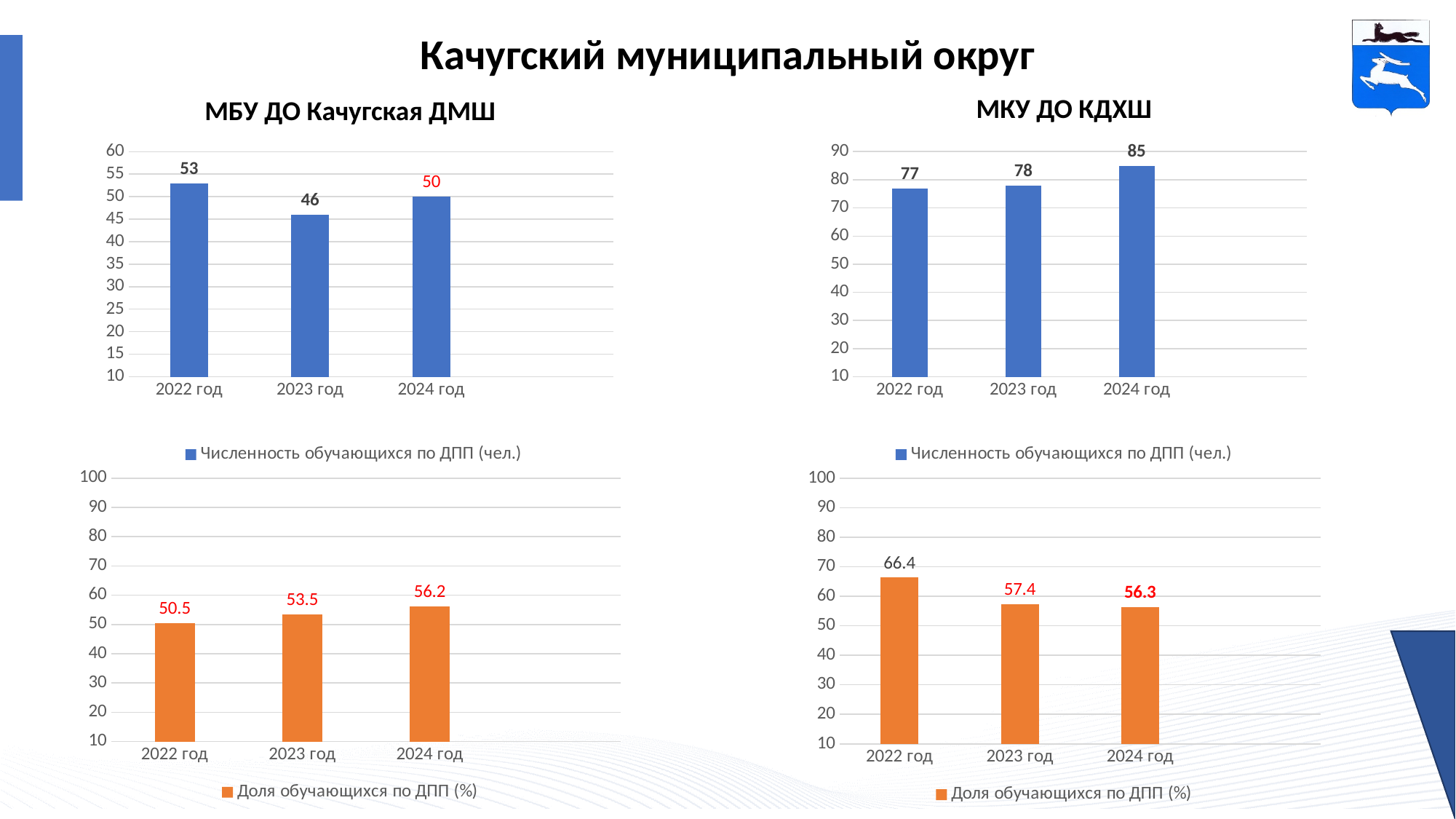
In the top-right chart (МКУ ДО КДХШ, Численность обучающихся по ДПП), what is the value for 2024 год? 85 What type of chart is the bottom-right chart (МКУ ДО КДХШ, Доля обучающихся по ДПП)? bar chart In the bottom-left chart (МБУ ДО Качугская ДМШ, Доля обучающихся по ДПП), do the values rise or fall from 2022 год to 2024 год? rise In the top-right chart (МКУ ДО КДХШ, Численность обучающихся по ДПП), which year has the highest value? 2024 год In the top-right chart (МКУ ДО КДХШ, Численность обучающихся по ДПП), what is the difference between the 2024 год and 2022 год values? 8 In the top-left chart (МБУ ДО Качугская ДМШ, Численность обучающихся по ДПП), which year has the lowest value? 2023 год In the bottom-right chart (МКУ ДО КДХШ, Доля обучающихся по ДПП), what is the difference between the 2022 год and 2024 год values? 10.1 In the bottom-right chart (МКУ ДО КДХШ, Доля обучающихся по ДПП), which is larger, the value for 2023 год or 2024 год? 2023 год In the top-left chart (МБУ ДО Качугская ДМШ, Численность обучающихся по ДПП), what is the value for 2022 год? 53 How many categories (years) are shown in the top-left chart (МБУ ДО Качугская ДМШ, Численность обучающихся по ДПП)? 3 In the bottom-left chart (МБУ ДО Качугская ДМШ, Доля обучающихся по ДПП), what is the value for 2023 год? 53.5 In the bottom-right chart (МКУ ДО КДХШ, Доля обучающихся по ДПП), what is the value for 2022 год? 66.4